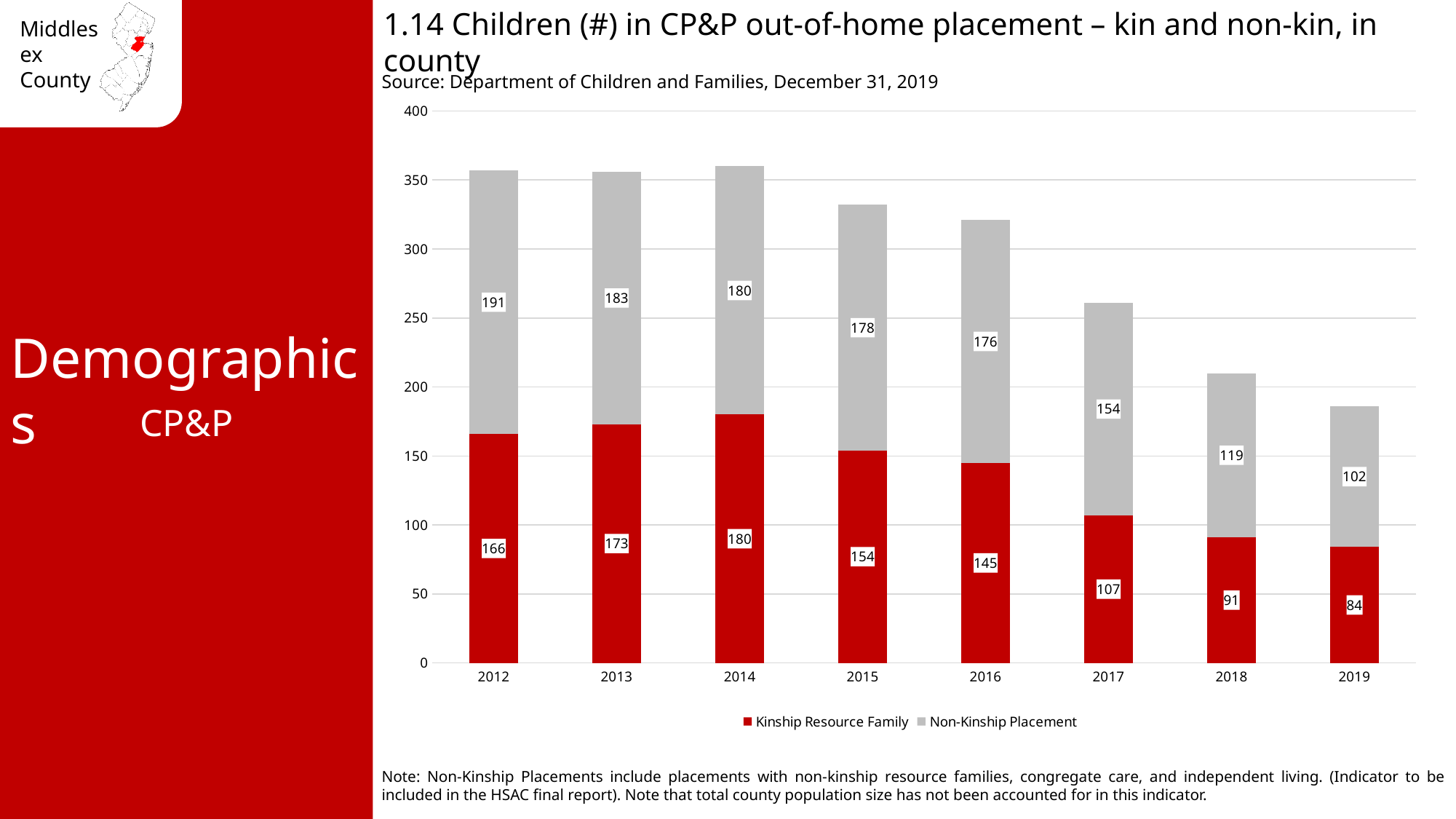
What is the total of the stacked bar for 2019? 186 What kind of chart is shown on the slide? Stacked bar chart Which is larger, the Non-Kinship Placement value for 2016 or for 2018? 2016 How many series does the legend list? 2 Is the total stacked bar for 2015 greater or less than 300? greater Which year has the lowest Kinship Resource Family value? 2019 Do the Kinship Resource Family values generally rise or fall from 2014 to 2019? Fall What is the Non-Kinship Placement value for 2017? 154 What is the difference between the Kinship Resource Family values for 2013 and 2018? 82 What is the Kinship Resource Family value for 2014? 180 Which year has the highest Non-Kinship Placement value? 2012 How many years are shown on the x axis? 8